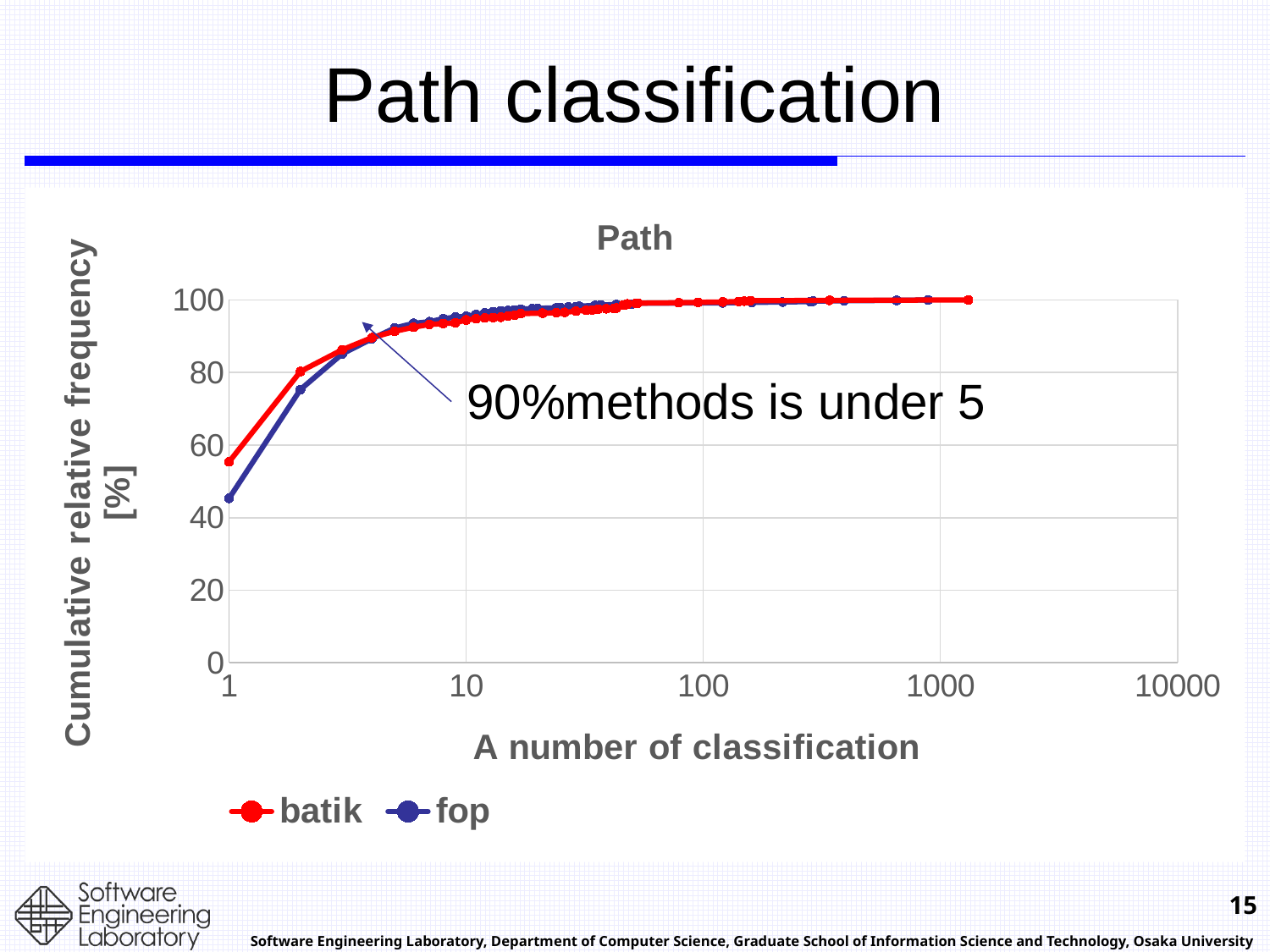
Is the value for batik at a number of classification of 100 greater or less than 80? greater What is the title of the chart? Path What kind of chart is shown on the slide? line chart Is the value for batik at a number of classification of 1 greater or less than 40? greater What are the names of the two series in the legend? batik and fop Do the values of the fop series rise or fall along the x axis? rise How many series does the legend list? 2 Is the value for fop at a number of classification of 1 greater or less than 60? less At a number of classification of 1, which series has the higher cumulative relative frequency, batik or fop? batik Do the values of the batik series rise or fall as the number of classification increases? rise